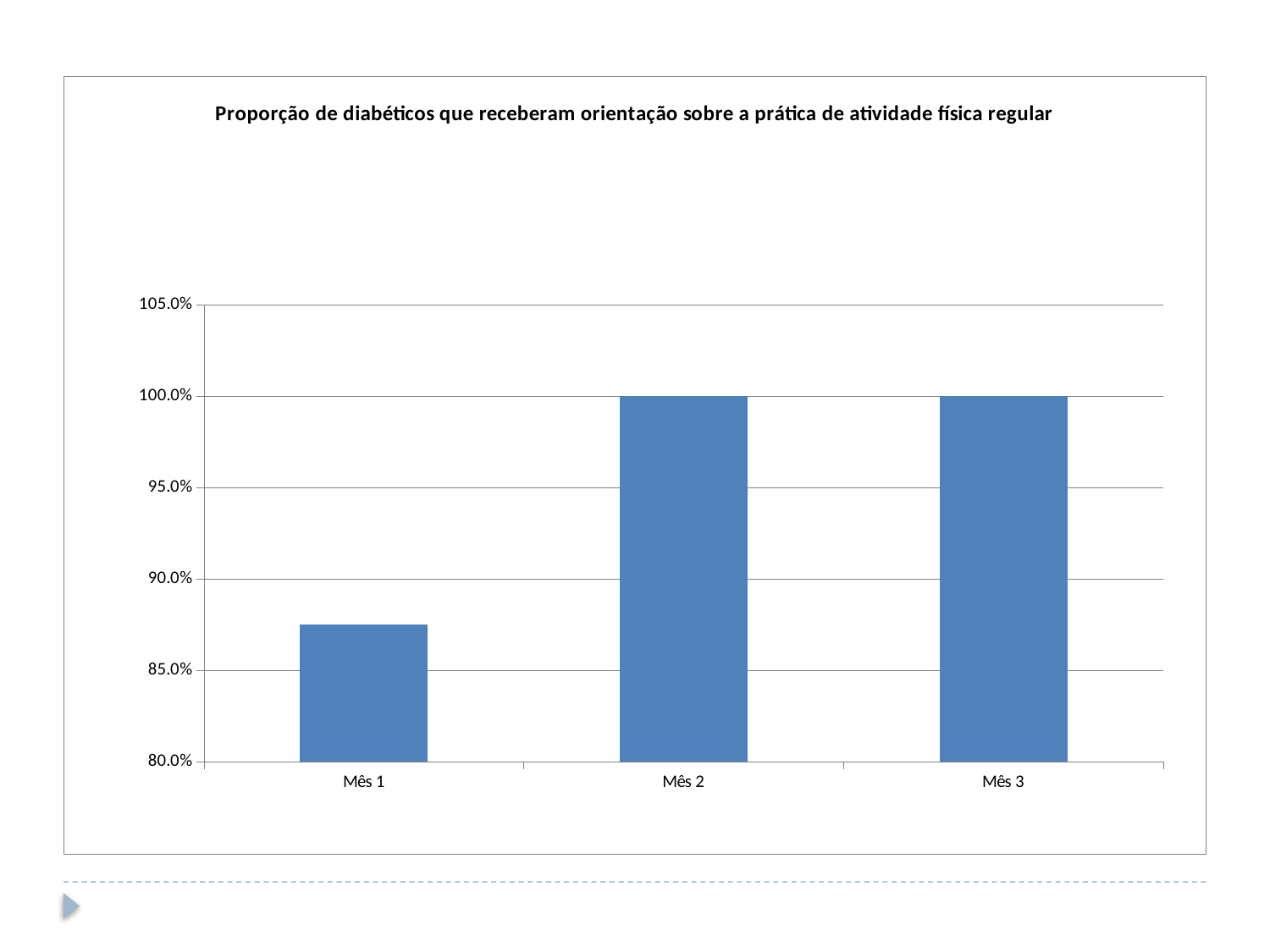
Which category has the lowest value? Mês 1 Is the value for Mês 1 greater or less than 90.0%? less Which is larger, the value for Mês 1 or the value for Mês 2? Mês 2 Is the value for Mês 1 greater or less than 85.0%? greater What is the value for Mês 3? 100.0% What type of chart is shown on the slide? bar chart Does the value rise or fall from Mês 1 to Mês 2? rise What is the value for Mês 2? 100.0% What is the lowest value shown on the y axis? 80.0% How many categories are plotted on the x axis? 3 What is the title of the chart? Proporção de diabéticos que receberam orientação sobre a prática de atividade física regular